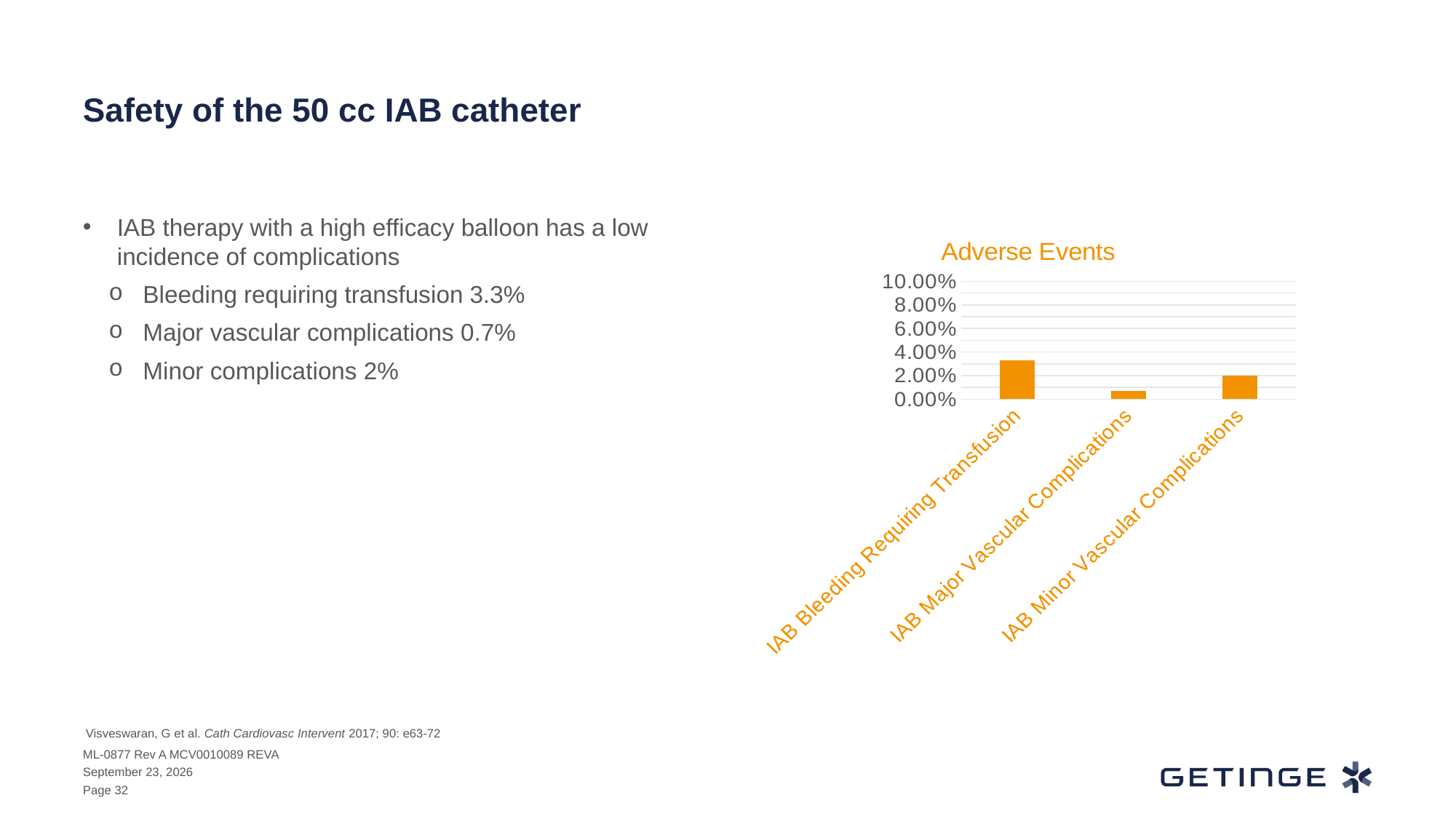
Which category has the highest value in the "Adverse Events" chart? IAB Bleeding Requiring Transfusion How many categories are plotted in the "Adverse Events" chart? 3 In the "Adverse Events" chart, is the value for IAB Bleeding Requiring Transfusion greater or less than 2.00%? greater What type of chart is shown under the title "Adverse Events"? bar chart In the "Adverse Events" chart, is the value for IAB Minor Vascular Complications greater or less than 4.00%? less In the "Adverse Events" chart, is the value for IAB Bleeding Requiring Transfusion greater or less than 4.00%? less In the "Adverse Events" chart, which is larger: IAB Bleeding Requiring Transfusion or IAB Major Vascular Complications? IAB Bleeding Requiring Transfusion In the "Adverse Events" chart, which is larger: IAB Minor Vascular Complications or IAB Major Vascular Complications? IAB Minor Vascular Complications What is the title of the chart on the slide? Adverse Events What is the highest value shown on the y axis of the "Adverse Events" chart? 10.00% Which category has the lowest value in the "Adverse Events" chart? IAB Major Vascular Complications